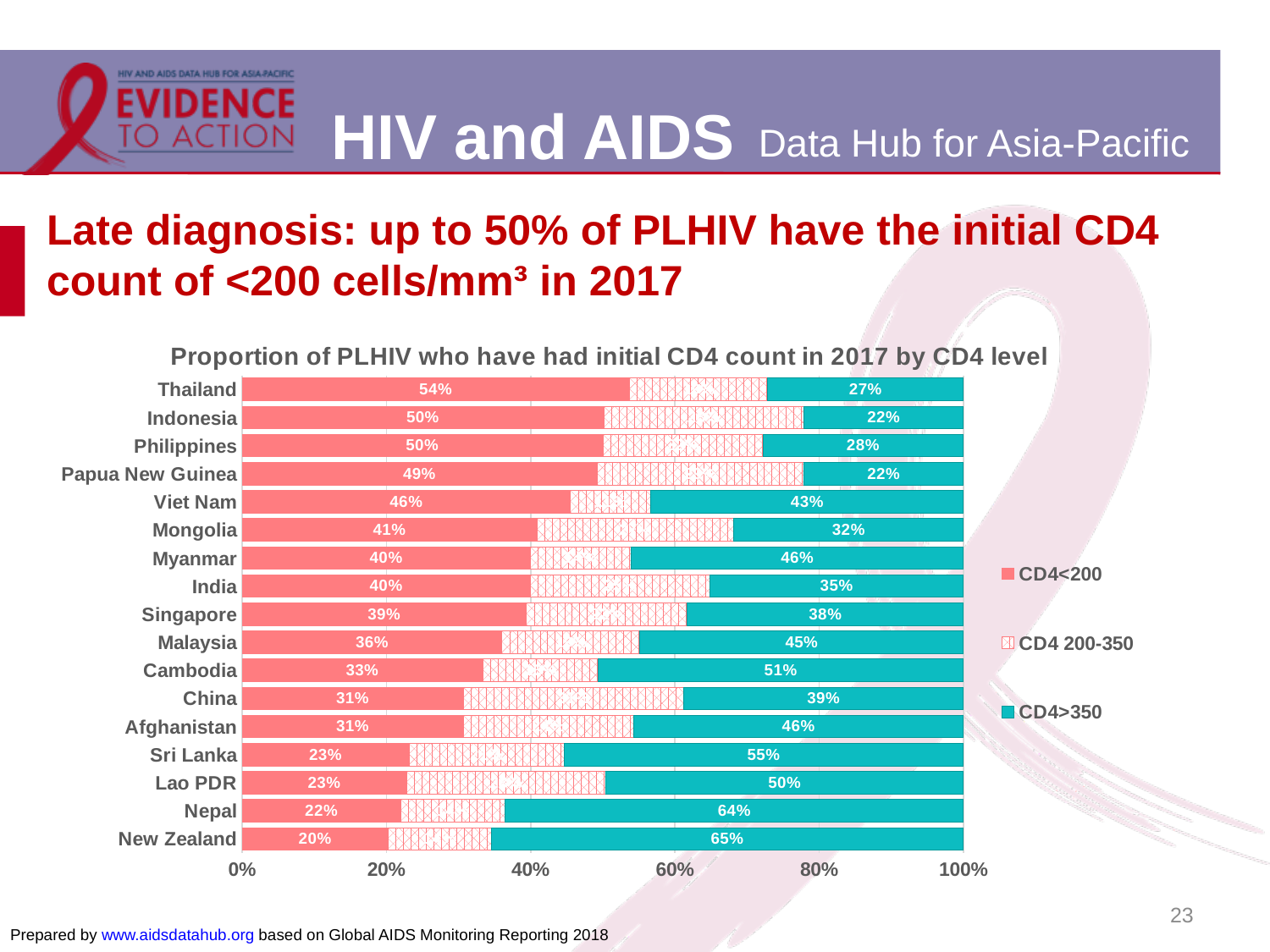
What percentage of PLHIV in Thailand had an initial CD4 count of <200? 54% What type of chart is shown on the slide? Stacked bar chart Which country has the highest proportion of PLHIV with CD4<200? Thailand What is the difference in percentage points between the CD4<200 values for Thailand and New Zealand? 34 percentage points How many countries are shown in the chart? 17 Which country has the highest CD4>350 proportion? New Zealand For Myanmar, which is larger: the CD4<200 share or the CD4>350 share? CD4>350 What is the CD4>350 value for Nepal? 64% For Cambodia, how many percentage points higher is the CD4>350 value than the CD4<200 value? 18 percentage points How many series does the legend list? 3 Which country has the lowest proportion of PLHIV with CD4<200? New Zealand What is the CD4>350 value for Viet Nam? 43%